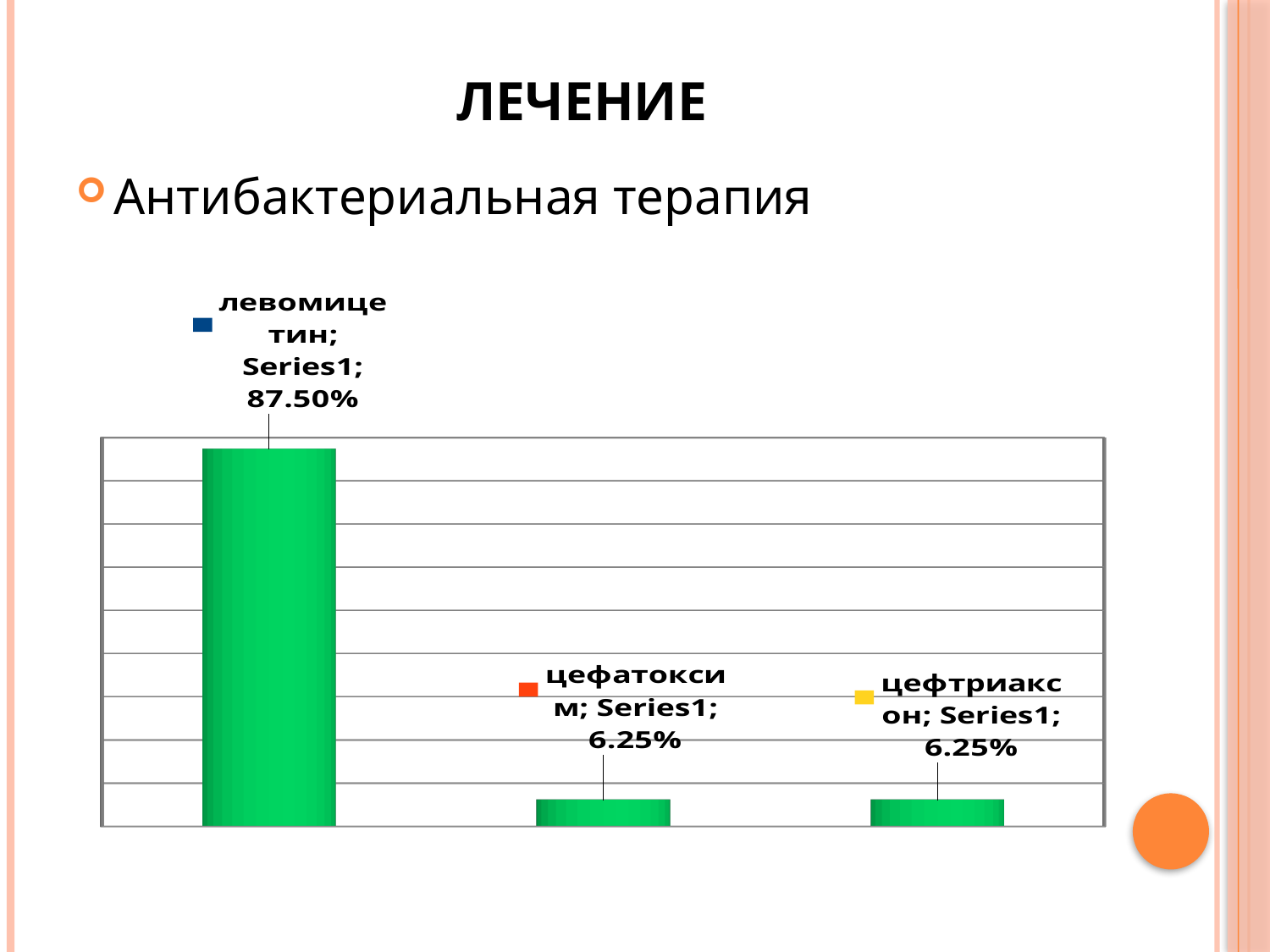
Which is larger, the value for левомицетин or the value for цефтриаксон? левомицетин What kind of chart is shown on the slide? Bar chart What is the title of the slide containing the chart? ЛЕЧЕНИЕ What colour are the bars in the chart? Green What value is shown for левомицетин? 87.50% What is the difference between the values for левомицетин and цефтриаксон? 81.25% What value is shown for цефатоксим? 6.25% Which category has the highest value? левомицетин What value is shown for цефтриаксон? 6.25% How many categories are plotted in the chart? 3 Do цефатоксим and цефтриаксон have the same value? Yes What is the difference between the values for левомицетин and цефатоксим? 81.25%